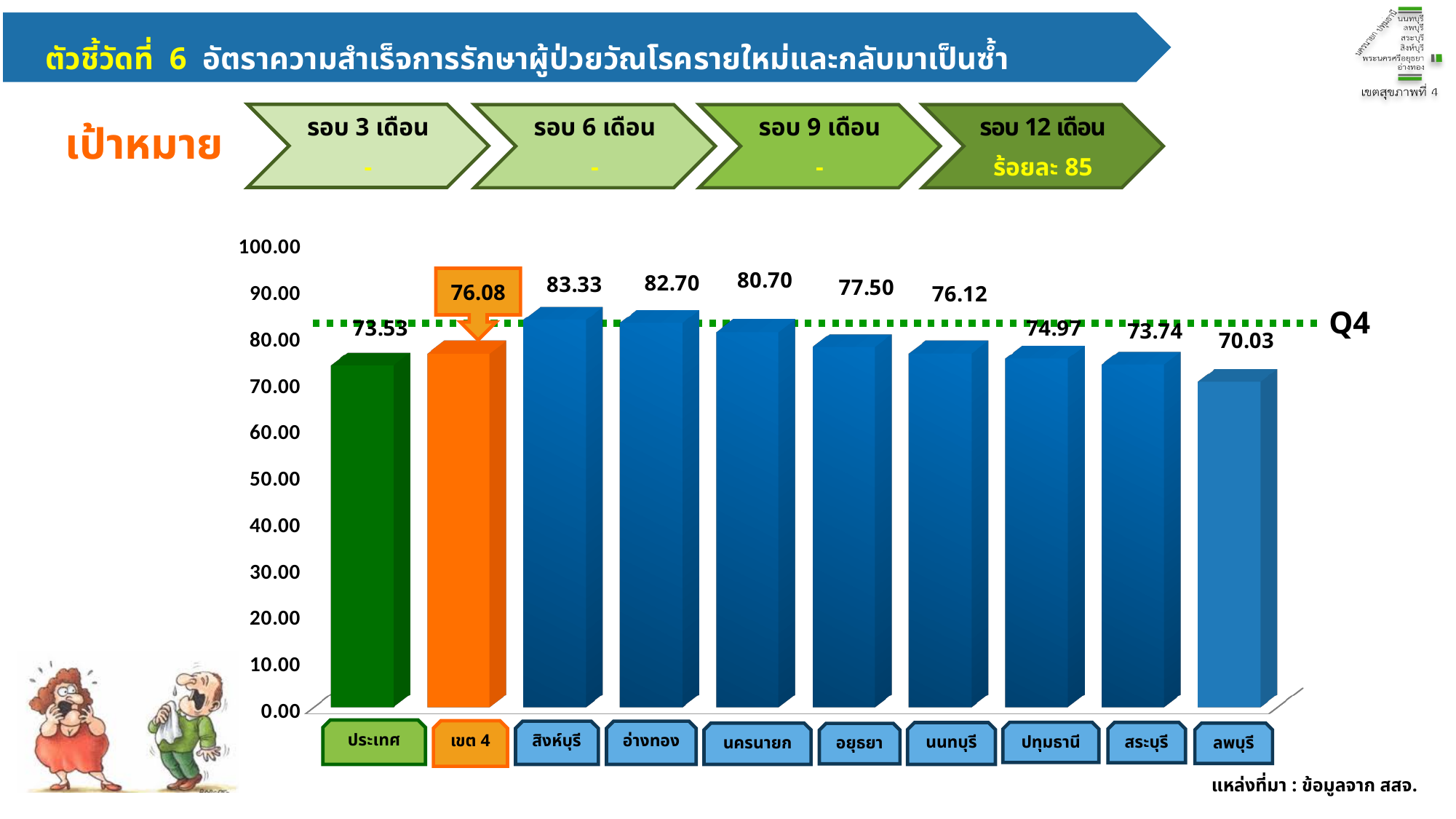
What kind of chart is shown on the slide? bar chart What is the value for ลพบุรี? 70.03 What is the difference between the values for เขต 4 and ประเทศ? 2.55 Which is larger, the value for อ่างทอง or the value for นครนายก? อ่างทอง Which category has the lowest value? ลพบุรี What is the difference between the values for สิงห์บุรี and ลพบุรี? 13.30 Is the value for อยุธยา greater or less than 70.00? greater What is the value for สิงห์บุรี? 83.33 How many categories are shown on the x axis? 10 Which category has the highest value? สิงห์บุรี What is the value for เขต 4? 76.08 What is the value for ประเทศ? 73.53